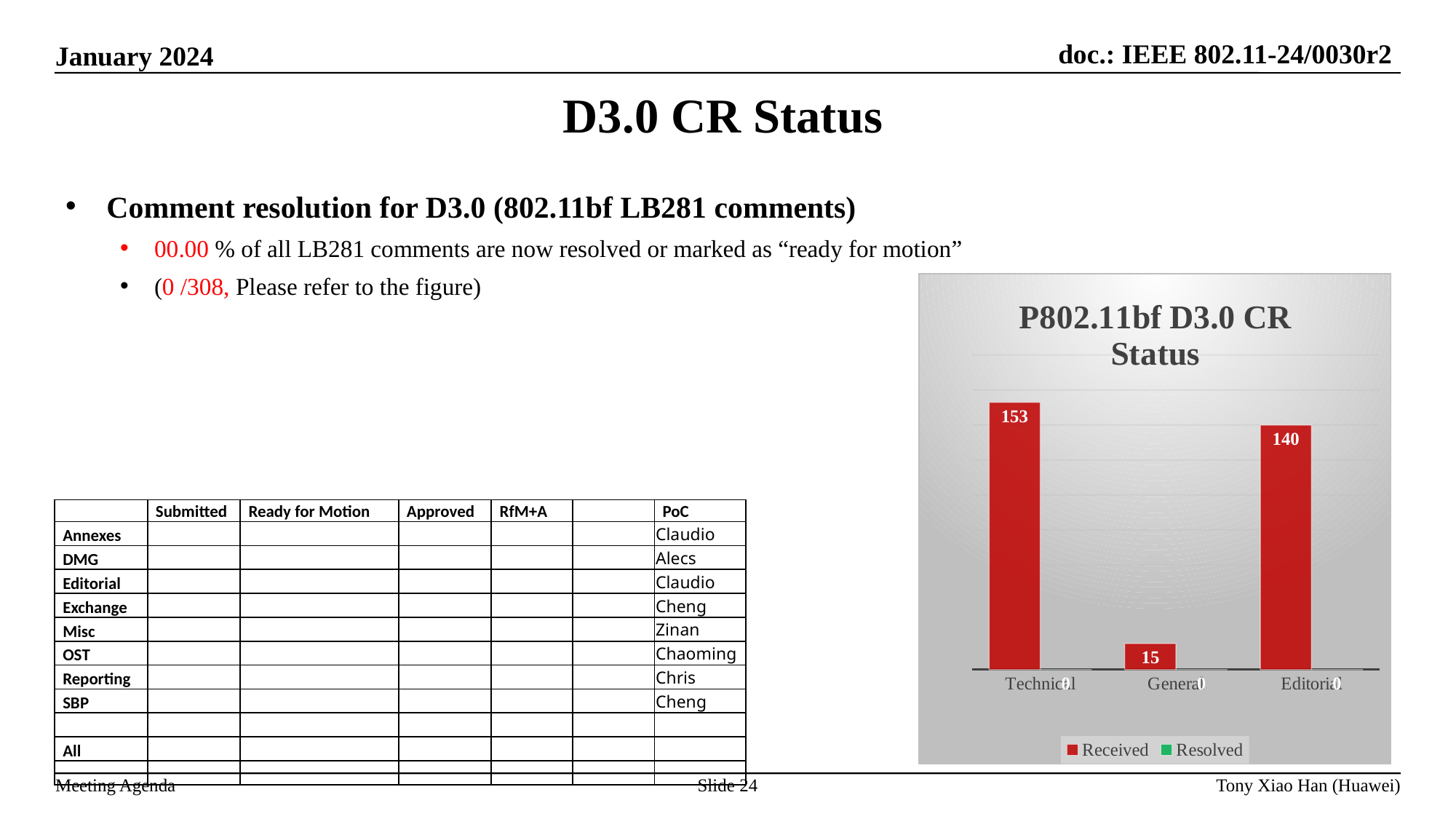
How many series does the chart legend list? 2 What is the title of the chart on the slide? P802.11bf D3.0 CR Status Which has a larger Received value, Technical or Editorial? Technical How many categories are shown on the x axis of the chart? 3 Which category has the highest Received value in the chart? Technical What is the difference between the Received values for Editorial and General? 125 What type of chart is shown on the slide? Bar chart Which category has the lowest Received value in the chart? General What is the Received value for General in the P802.11bf D3.0 CR Status chart? 15 What is the Received value for Technical in the P802.11bf D3.0 CR Status chart? 153 What is the Received value for Editorial in the P802.11bf D3.0 CR Status chart? 140 What is the difference between the Received values for Technical and Editorial? 13